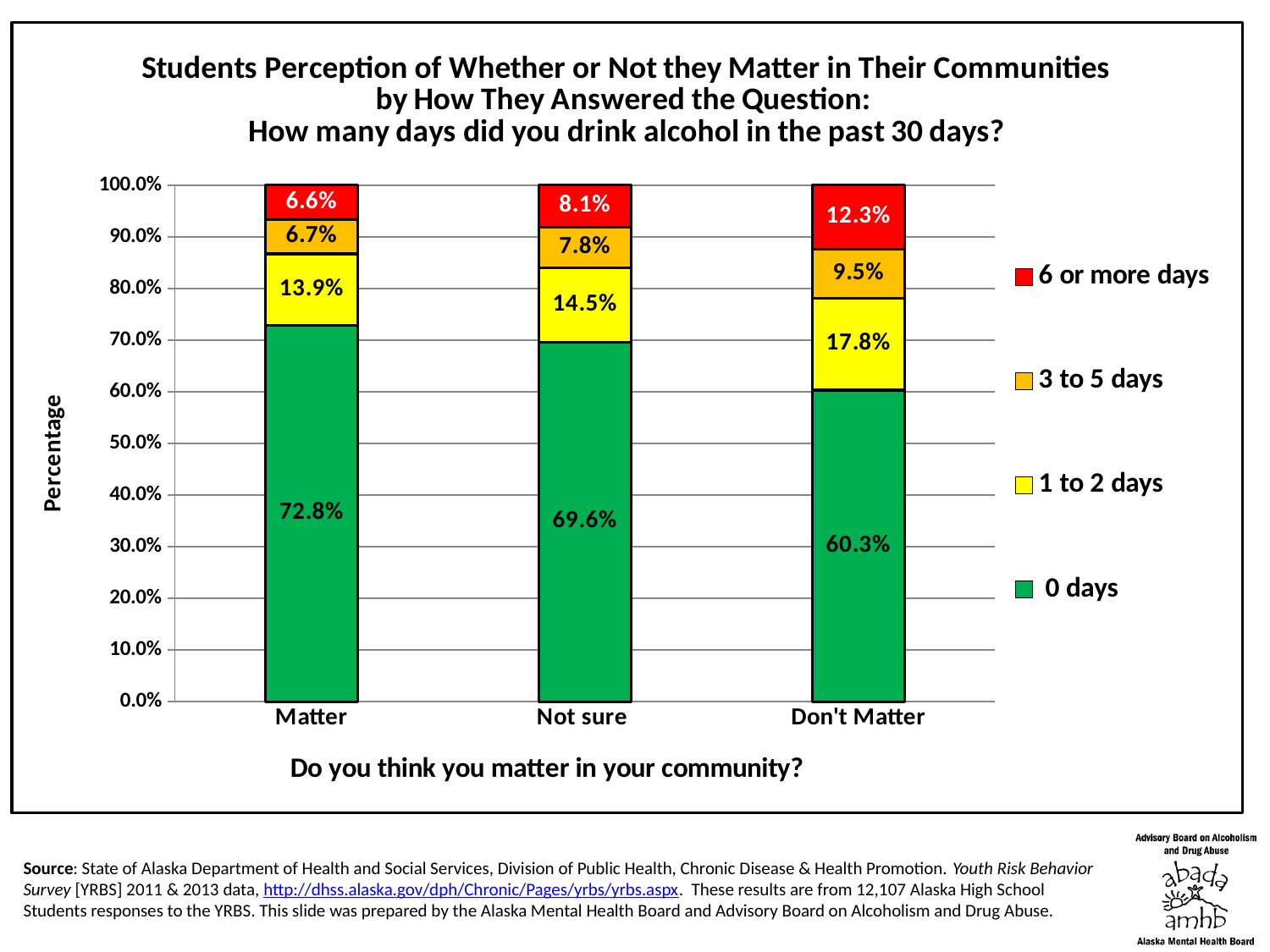
Which category has the lowest percentage for 6 or more days? Matter Does the 0 days percentage rise or fall moving from "Matter" to "Don't Matter" along the x axis? Fall Which category has the highest percentage for 0 days? Matter What kind of chart is shown on the slide? Stacked bar chart How many categories are shown on the x axis? 3 What is the difference between the 0 days percentage for "Matter" and for "Don't Matter"? 12.5% What colour represents the 6 or more days series? Red What percentage of students who answered "Matter" reported 0 days of drinking alcohol in the past 30 days? 72.8% What percentage of students who answered "Don't Matter" reported 6 or more days of drinking? 12.3% Which is larger: the 3 to 5 days value for "Not sure" or for "Don't Matter"? Don't Matter What is the value for 1 to 2 days in the "Not sure" bar? 14.5% How many series does the legend list? 4